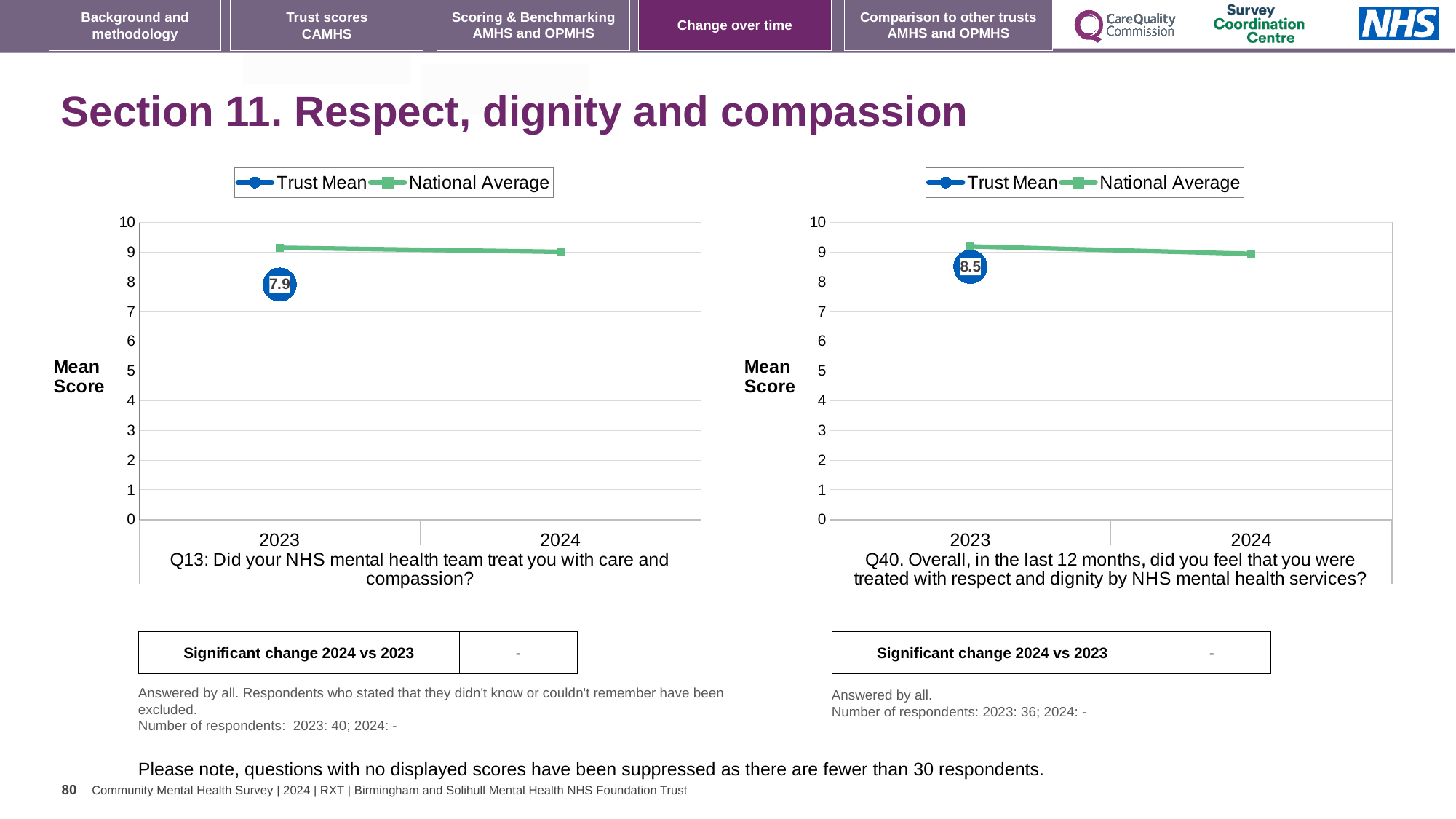
How many series does the legend of the Q40 chart on the right list? 2 What are the two series named in the legend of the Q13 chart on the left? Trust Mean and National Average In the Q40 chart on the right, which is higher for 2023: the Trust Mean or the National Average? National Average In the Q40 chart on the right, does the National Average rise or fall from 2023 to 2024? Fall In the Q13 chart on the left, what is the Trust Mean score for 2023? 7.9 In the Q40 chart on the right, what is the Trust Mean score for 2023? 8.5 What kind of chart is the Q13 chart on the left? Line chart What is the y-axis label of the Q40 chart on the right? Mean Score How many years are shown on the x axis of the Q13 chart on the left? 2 In the Q13 chart on the left, is the National Average for 2023 greater or less than 8? greater In the Q13 chart on the left, which is higher for 2023: the Trust Mean or the National Average? National Average In the Q40 chart on the right, is the National Average for 2024 greater or less than 8? greater